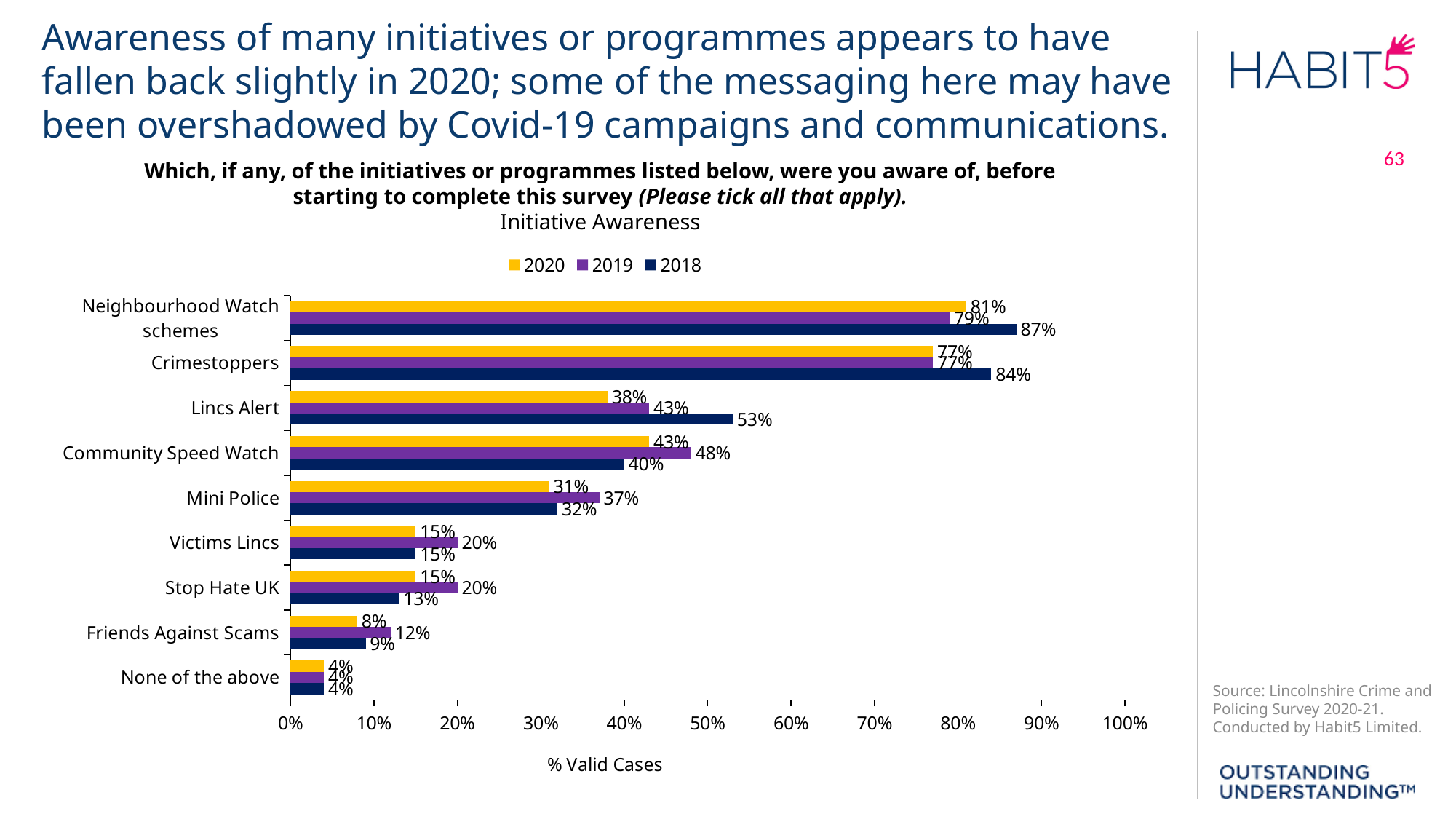
What percentage of respondents were aware of Neighbourhood Watch schemes in 2018? 87% Which initiative has the highest awareness in 2020? Neighbourhood Watch schemes What is the 2020 value for Lincs Alert? 38% How many series does the legend list? 3 What is the label on the horizontal axis? % Valid Cases How many initiatives or categories are listed on the chart? 9 What kind of chart is shown on the slide? Bar chart What is the 2019 value for Community Speed Watch? 48% What is the title of the chart? Initiative Awareness Which initiative has the lowest awareness in 2019? Friends Against Scams What is the difference between the 2018 and 2020 values for Lincs Alert? 15% Which is larger for Mini Police: the 2019 value or the 2020 value? 2019